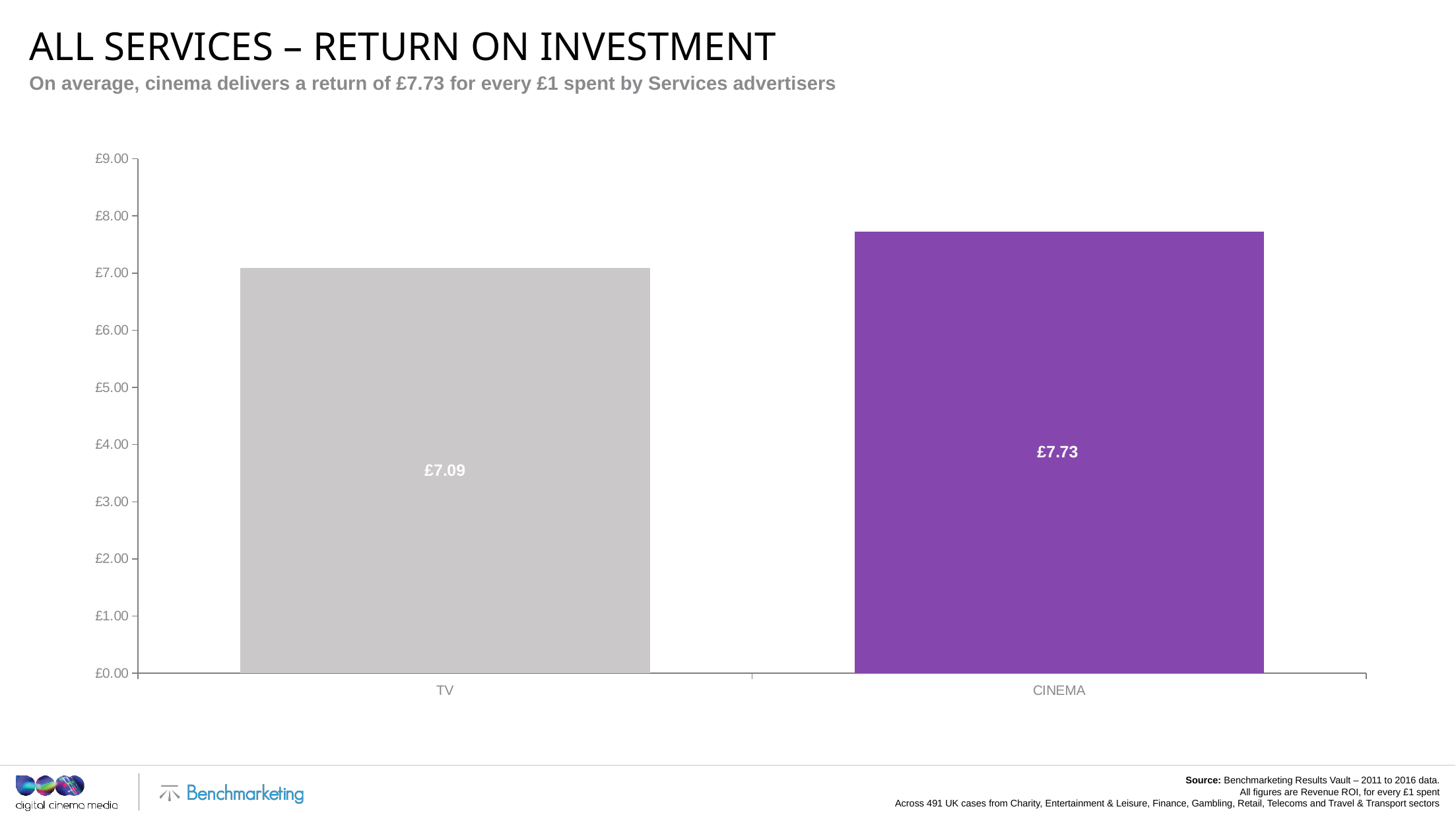
What colour is the CINEMA bar? purple What is the difference between the CINEMA and TV return on investment values? £0.64 Which is larger, the value for TV or the value for CINEMA? CINEMA Is the value for CINEMA greater or less than £8.00? less Is the value for TV greater or less than £7.00? greater What is the return on investment value shown for CINEMA? £7.73 Which category has the lowest return on investment? TV How many categories are shown on the x axis? 2 What is the return on investment value shown for TV? £7.09 What kind of chart is shown on the slide? bar chart What is the title of the slide? ALL SERVICES – RETURN ON INVESTMENT Which category has the highest return on investment? CINEMA